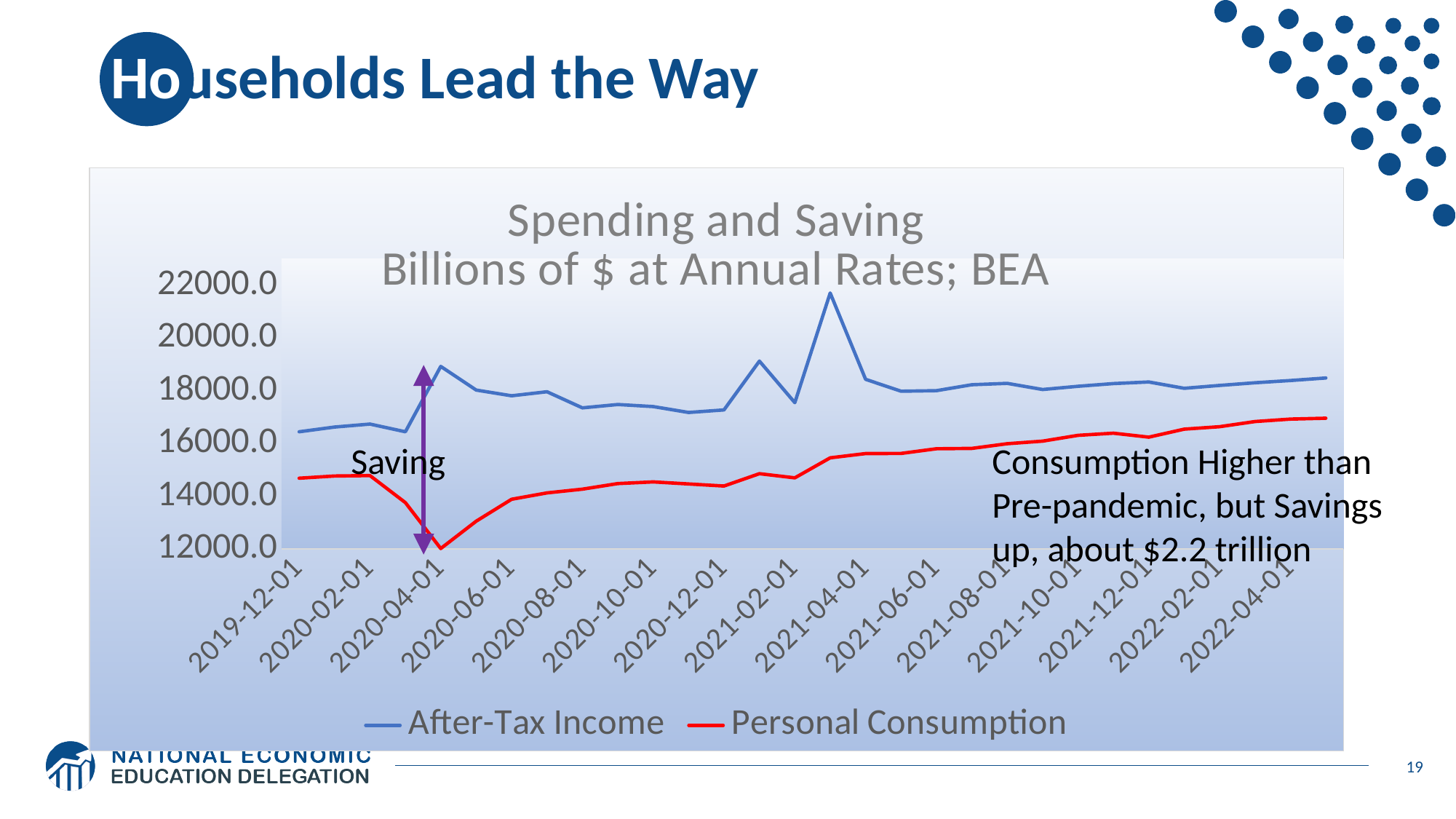
What are the two series named in the chart's legend? After-Tax Income and Personal Consumption Is the value of Personal Consumption at 2019-12-01 greater or less than 14000.0? greater What is the title of the chart? Spending and Saving Billions of $ at Annual Rates; BEA What kind of chart is shown on the slide? line chart Is the value of Personal Consumption at 2022-04-01 greater or less than 16000.0? greater Is the peak value of After-Tax Income greater or less than 20000.0? greater At which x-axis date does Personal Consumption reach its lowest value? 2020-04-01 At 2020-04-01, which series has the larger value, After-Tax Income or Personal Consumption? After-Tax Income How many series does the chart's legend list? 2 Which series reaches the highest value anywhere on the chart? After-Tax Income Does Personal Consumption generally rise or fall from 2020-06-01 to 2022-04-01? rise